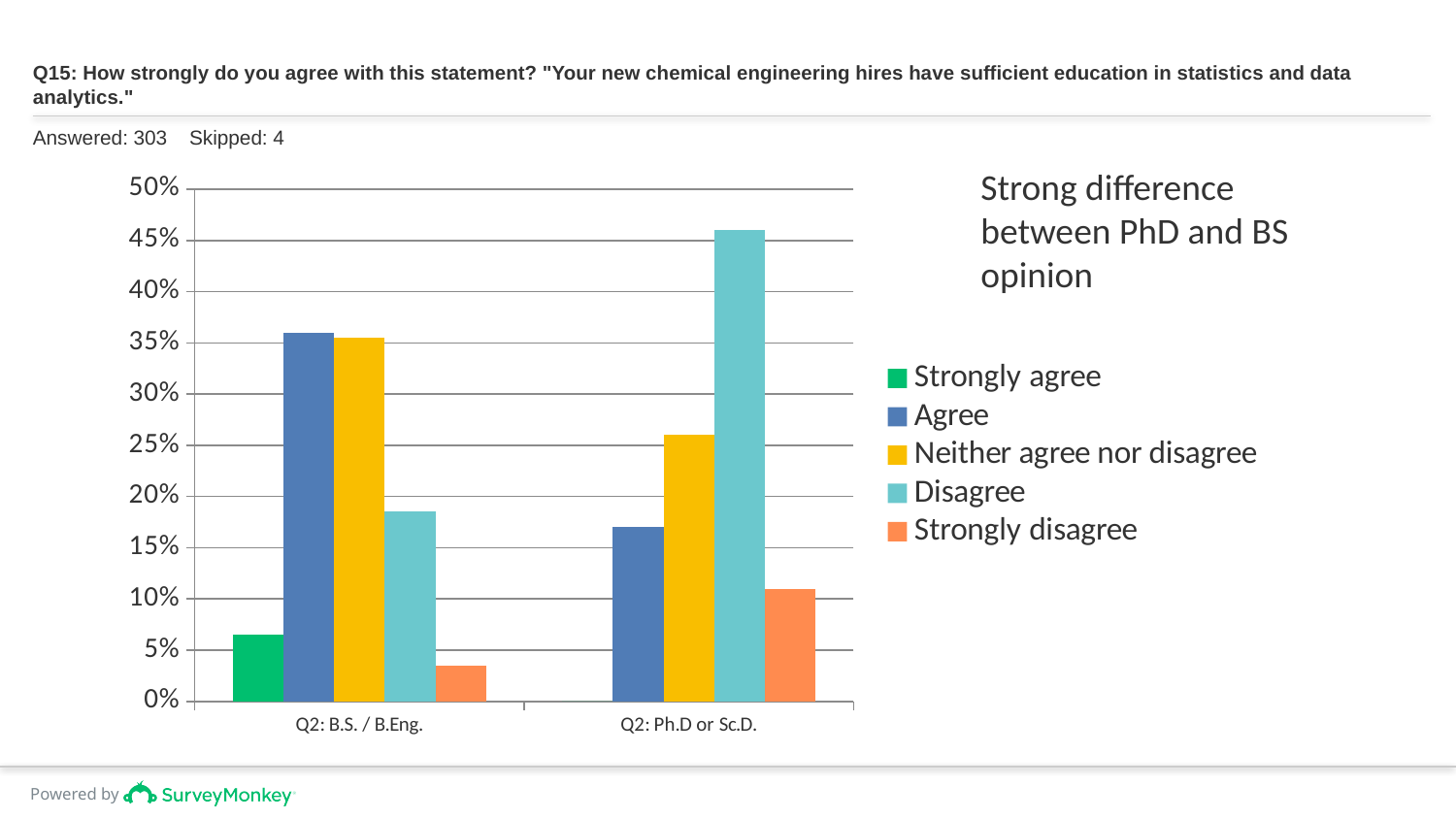
Which response has the highest value for Q2: Ph.D or Sc.D.? Disagree Which category has the larger Agree value, Q2: B.S. / B.Eng. or Q2: Ph.D or Sc.D.? Q2: B.S. / B.Eng. How many categories are shown on the x axis? 2 Is the Agree value for Q2: Ph.D or Sc.D. greater or less than 20%? less How many series does the legend list? 5 Is the Agree value for Q2: B.S. / B.Eng. greater or less than 30%? greater Which response has the lowest value for Q2: B.S. / B.Eng.? Strongly disagree Is the Disagree value for Q2: Ph.D or Sc.D. greater or less than 40%? greater What kind of chart is shown on the slide? bar chart Which category has the larger Disagree value, Q2: B.S. / B.Eng. or Q2: Ph.D or Sc.D.? Q2: Ph.D or Sc.D.